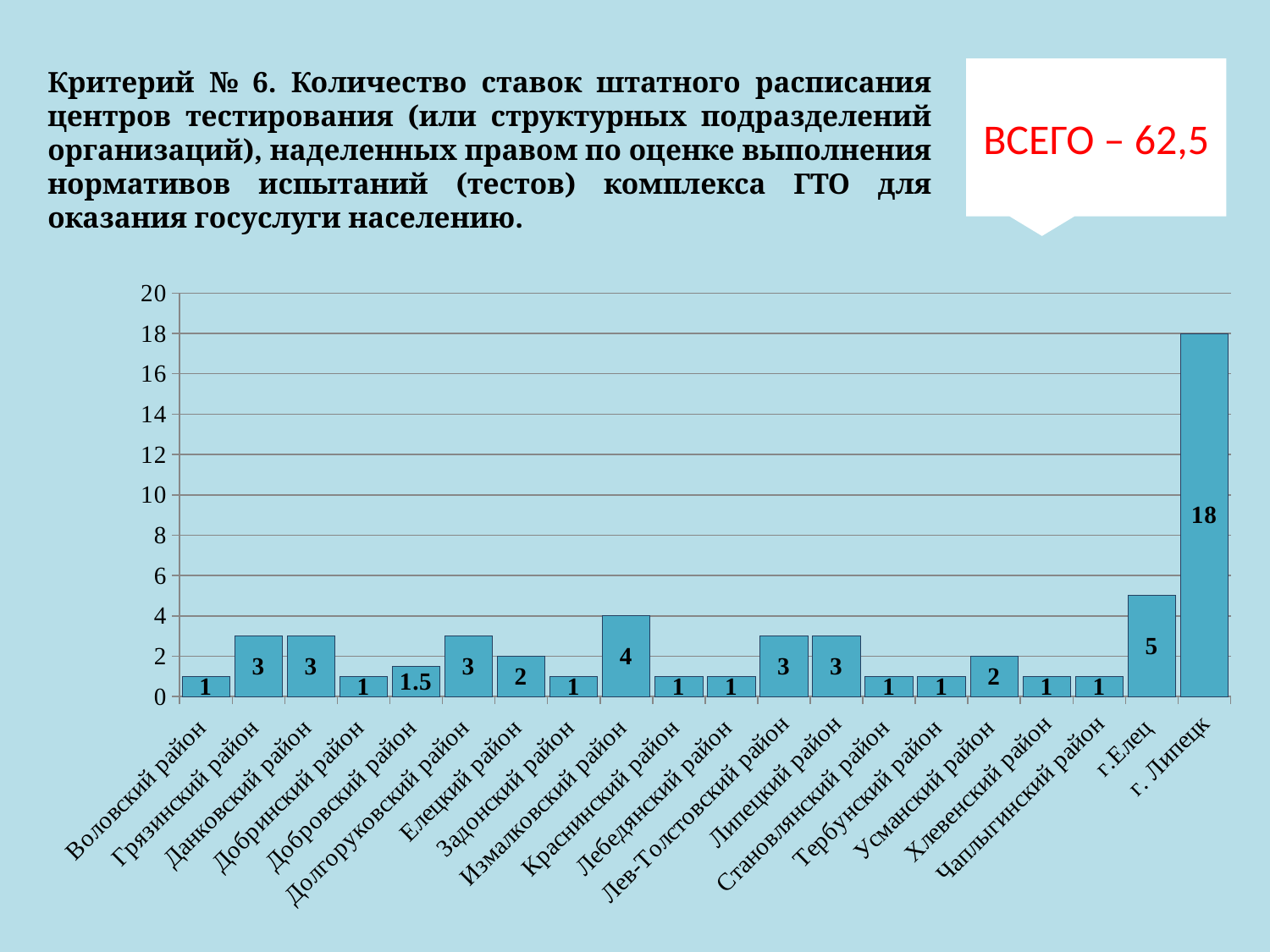
What is the difference between the values for г. Липецк and г.Елец? 13 How many categories (districts and cities) are plotted on the chart? 20 Is the value for г. Липецк greater or less than 10? greater What is the value for Добровский район? 1.5 Which is larger, the value for Измалковский район or the value for Елецкий район? Измалковский район What is the value for г. Липецк? 18 What is the total shown in the callout box at the top right of the slide? 62,5 What is the value for Измалковский район? 4 What type of chart is shown on the slide? bar chart What is the value for г.Елец? 5 Which category has the highest value on the chart? г. Липецк What is the highest value marked on the vertical axis? 20